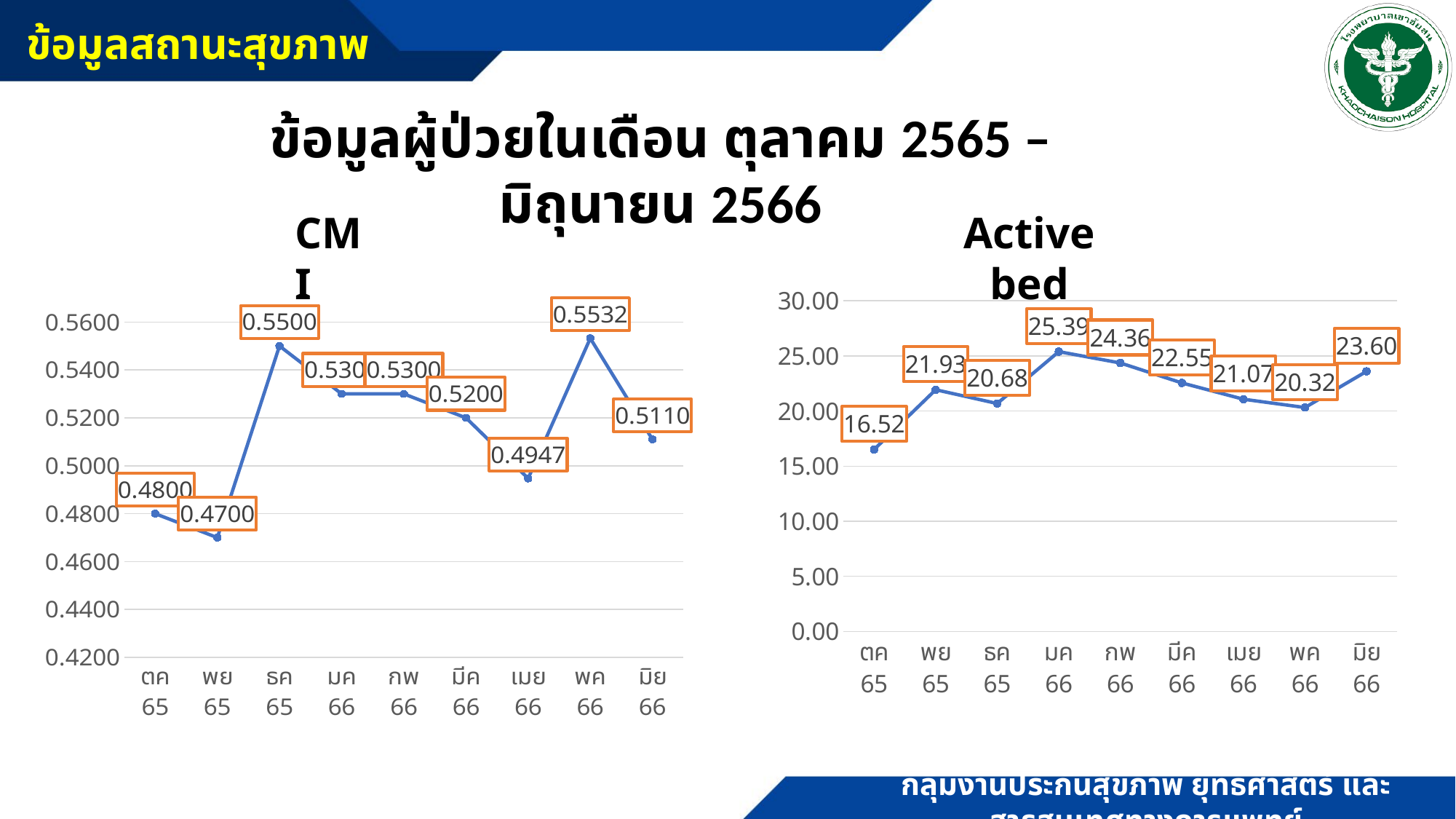
In the Active bed chart, which month has the highest value? มค 66 In the CMI chart, which month has the highest value? พค 66 In the Active bed chart, what is the value for มิย 66? 23.60 In the CMI chart, what is the value for ธค 65? 0.5500 In the CMI chart, which month has the lowest value? พย 65 What kind of chart is the Active bed chart? line chart In the CMI chart, which is larger, the value for เมย 66 or the value for มิย 66? มิย 66 In the Active bed chart, do the values rise or fall from มค 66 to พค 66? fall In the Active bed chart, what is the difference between the values for มค 66 and ตค 65? 8.87 How many months are plotted in the CMI chart? 9 In the Active bed chart, which month has the lowest value? ตค 65 In the Active bed chart, is the value for พค 66 greater or less than 25.00? less